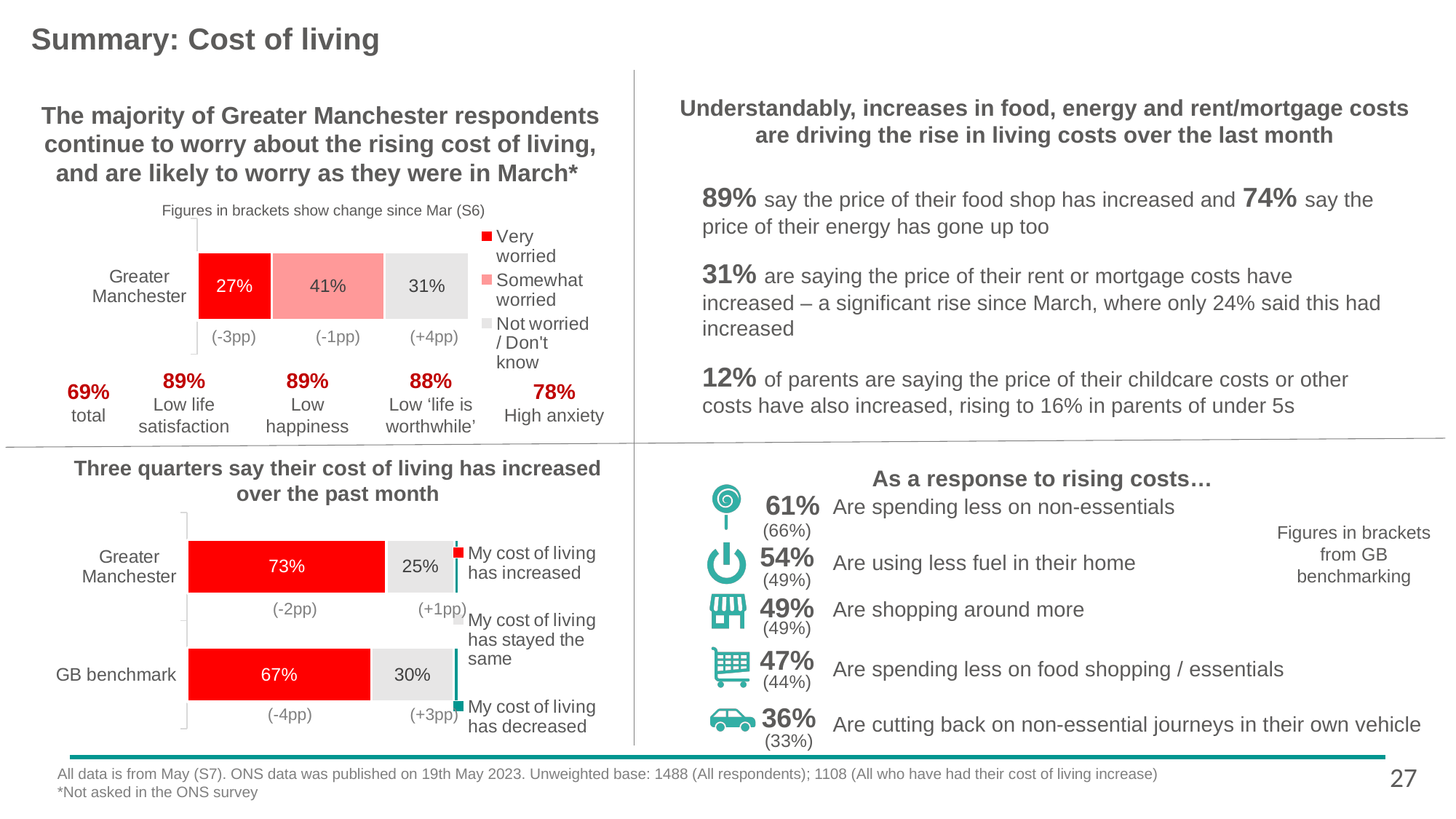
In the bottom-left chart on cost of living increasing over the past month, what percentage of the GB benchmark say their cost of living has increased? 67% What kind of chart is the bottom-left chart on cost of living increasing over the past month? Bar chart In the top-left chart on worry about the cost of living, what change since March is shown in brackets under the 'Not worried / Don't know' segment? (+4pp) In the bottom-left chart on cost of living increasing over the past month, what is the difference between Greater Manchester and the GB benchmark for 'My cost of living has increased'? 6 percentage points In the bottom-left chart on cost of living increasing over the past month, how many categories (bars) are shown? 2 In the bottom-left chart on cost of living increasing over the past month, what percentage of Greater Manchester respondents say their cost of living has stayed the same? 25% In the top-left chart on worry about the cost of living, what percentage of Greater Manchester respondents are 'Very worried'? 27% In the bottom-left chart on cost of living increasing over the past month, which has the larger share saying their cost of living has stayed the same: Greater Manchester or GB benchmark? GB benchmark In the top-left chart on worry about the cost of living, what is the difference between the 'Somewhat worried' and 'Very worried' shares? 14 percentage points In the top-left chart on worry about the cost of living, how many series does the legend list? 3 In the top-left chart on worry about the cost of living, which response category has the largest share for Greater Manchester? Somewhat worried In the top-left chart on worry about the cost of living, what percentage of Greater Manchester respondents are 'Somewhat worried'? 41%